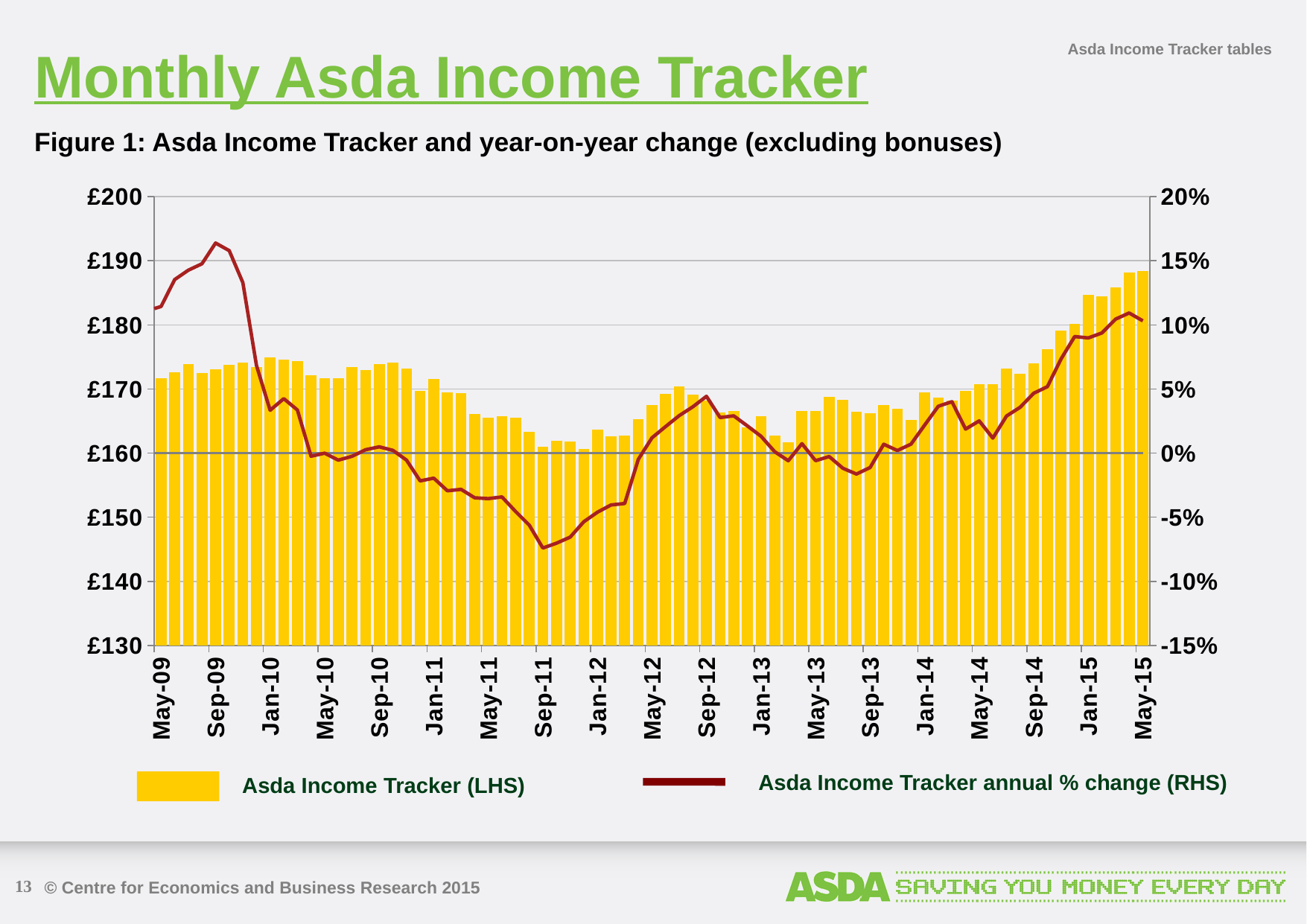
Is the Asda Income Tracker bar for May-15 greater or less than £180? greater How many series does the legend list? 2 What is the title of the figure? Figure 1: Asda Income Tracker and year-on-year change (excluding bonuses) Which series is plotted as bars according to the legend? Asda Income Tracker (LHS) Is the annual % change line at Sep-11 greater or less than -5%? less At which labelled month is the Asda Income Tracker bar highest? May-15 At which labelled month does the annual % change line reach its lowest point? Sep-11 Which is larger, the Asda Income Tracker bar for Sep-11 or for Sep-12? Sep-12 Is the annual % change line at May-15 greater or less than 5%? greater Do the Asda Income Tracker bars rise or fall from Jan-14 to May-15? rise What kind of chart is shown in Figure 1? A combined bar and line chart